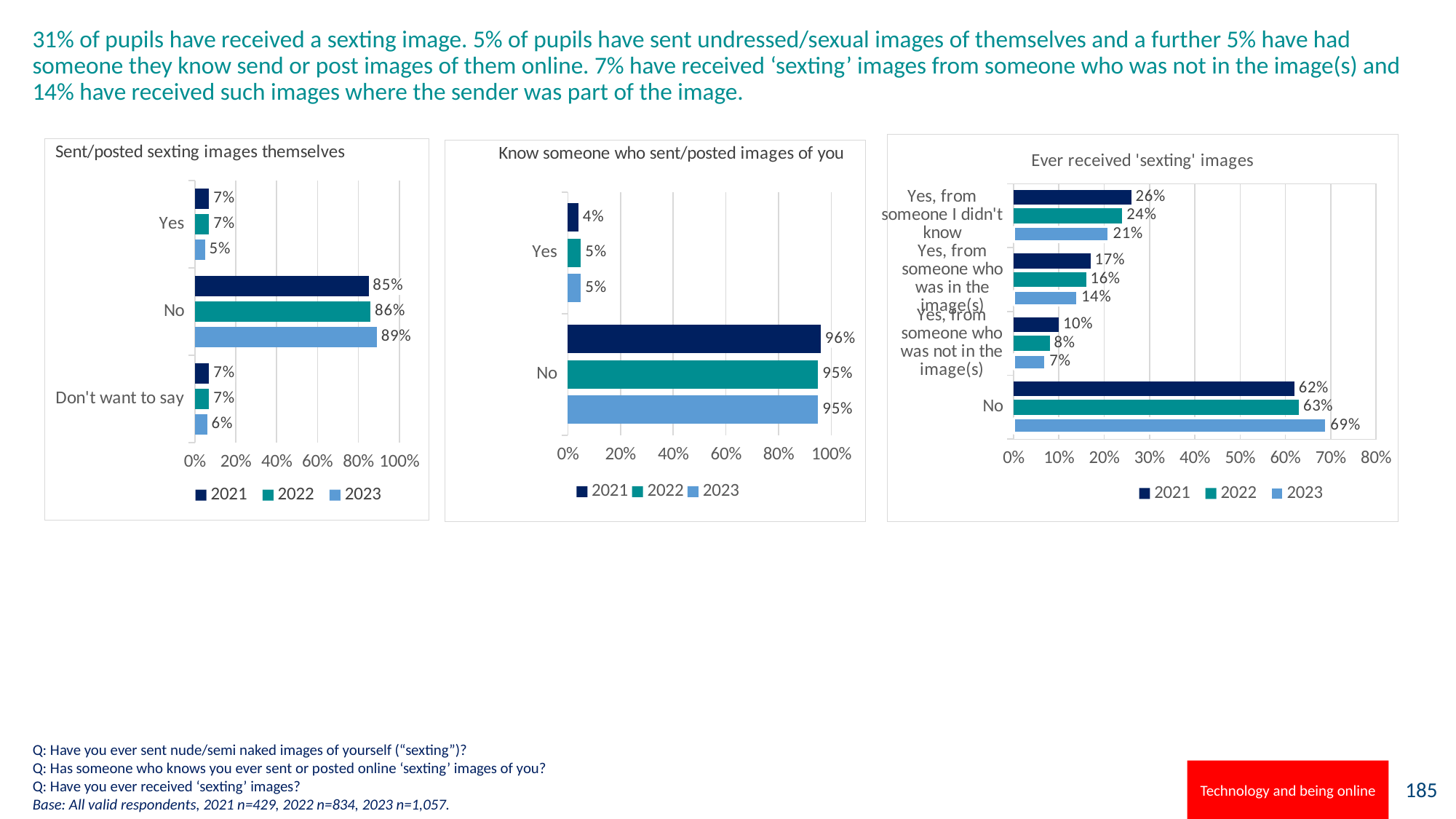
In the 'Ever received 'sexting' images' chart, which category has the highest value in 2022? No In the 'Know someone who sent/posted images of you' chart, what is the value for 'Yes' in 2021? 4% In the 'Sent/posted sexting images themselves' chart, is the 2022 value for 'No' larger or smaller than the 2023 value for 'No'? smaller In the 'Ever received 'sexting' images' chart, which category has the lowest value in 2023? Yes, from someone who was not in the image(s) In the 'Ever received 'sexting' images' chart, what is the value for 'No' in 2023? 69% In the 'Know someone who sent/posted images of you' chart, what is the value for 'No' in 2021? 96% In the 'Sent/posted sexting images themselves' chart, what is the value for 'Yes' in 2023? 5% What kind of chart is the 'Ever received 'sexting' images' chart? bar chart In the 'Ever received 'sexting' images' chart, what is the difference between the 2021 and 2023 values for 'No'? 7% In the 'Sent/posted sexting images themselves' chart, what is the value for 'No' in 2023? 89% How many series does the legend list in the 'Know someone who sent/posted images of you' chart? 3 In the 'Ever received 'sexting' images' chart, what is the value for 'Yes, from someone I didn't know' in 2021? 26%